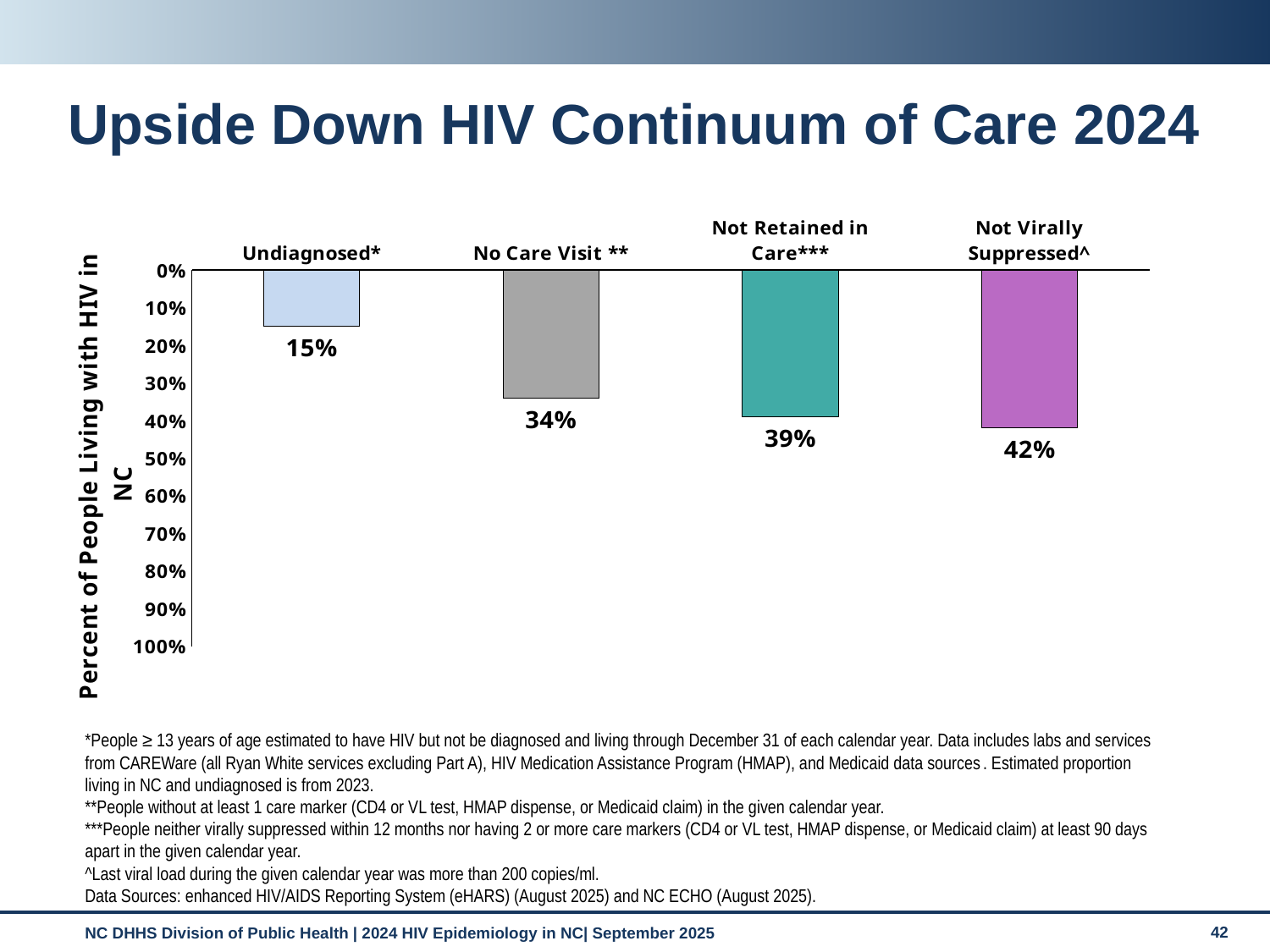
What kind of chart is shown on the slide? Bar chart Which is larger, the value for No Care Visit ** or the value for Undiagnosed*? No Care Visit ** What is the value for Not Virally Suppressed^? 42% What is the value for Not Retained in Care***? 39% Which category has the lowest value? Undiagnosed* What is the title of the slide's chart? Upside Down HIV Continuum of Care 2024 What is the value for Undiagnosed*? 15% What is the difference between the values for Not Retained in Care*** and No Care Visit **? 5% What is the difference between the values for Not Virally Suppressed^ and Undiagnosed*? 27% How many categories are shown in the chart? 4 What is the value for No Care Visit **? 34% Which category has the highest value? Not Virally Suppressed^